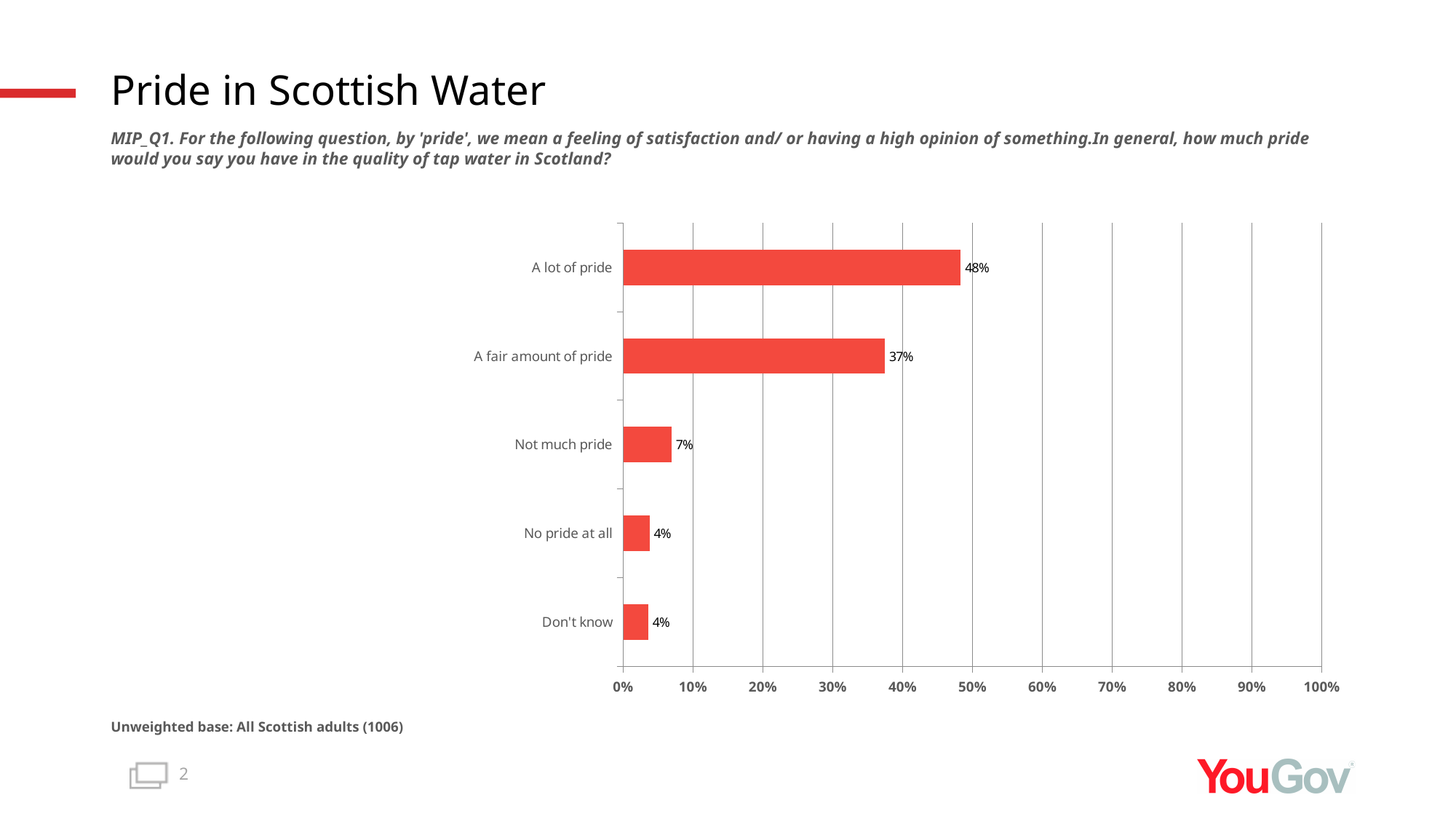
Which response category has the lowest value, 'Not much pride' or 'No pride at all'? No pride at all What percentage of respondents said they have 'A lot of pride' in the quality of tap water in Scotland? 48% Which response category has the highest value? A lot of pride What is the value shown for 'A fair amount of pride'? 37% What type of chart is used on this slide? Bar chart What percentage of respondents said 'Not much pride'? 7% Which is larger, the value for 'Not much pride' or the value for 'No pride at all'? Not much pride What is the unweighted base stated below the chart? All Scottish adults (1006) What is the value for 'Don't know'? 4% Is the value for 'A fair amount of pride' greater or less than 40%? less How many response categories are shown in the chart? 5 What is the difference between 'A lot of pride' and 'A fair amount of pride'? 11 percentage points